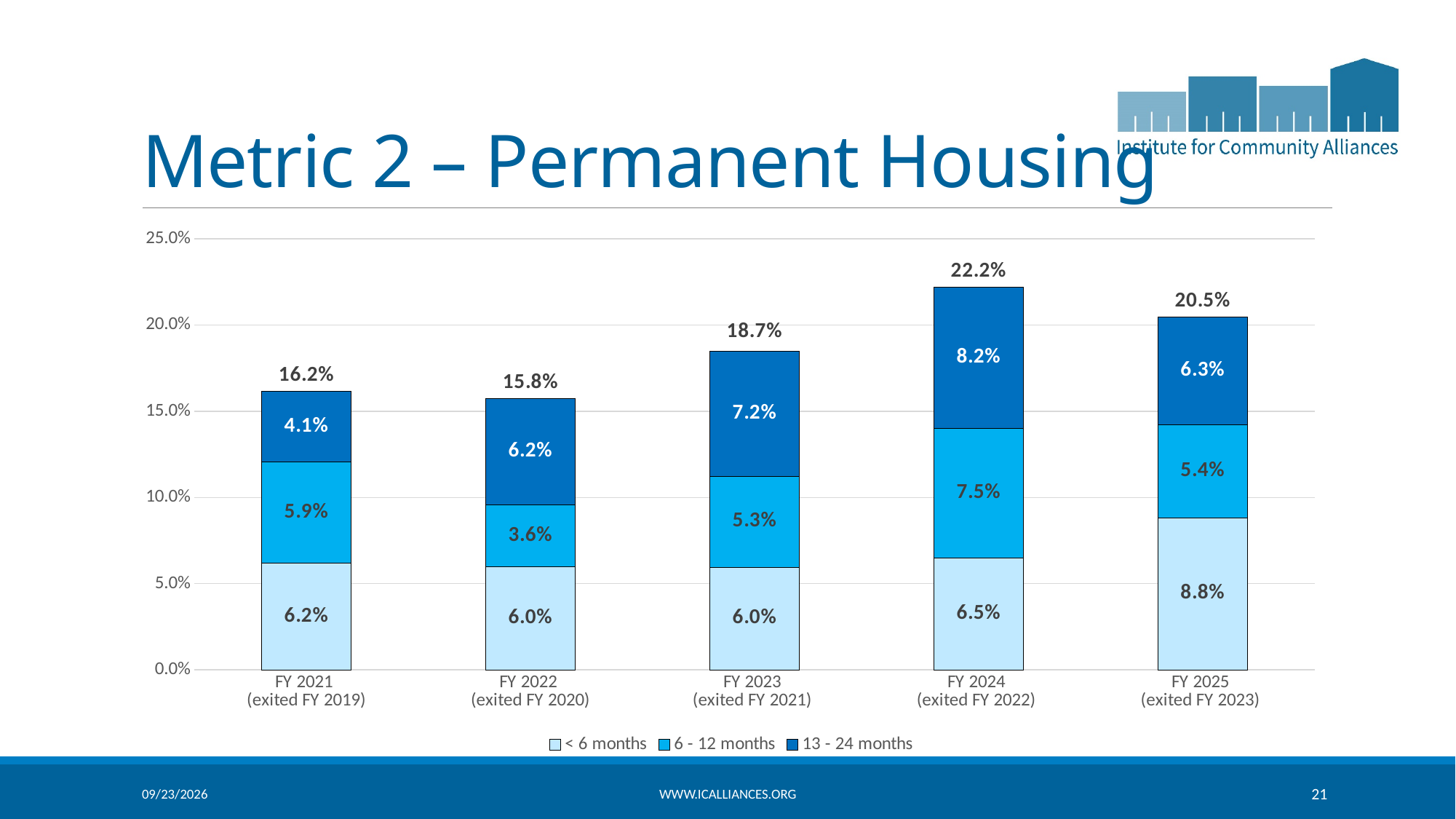
How many fiscal years are shown on the x axis? 5 Which is larger: the 6 - 12 months value in FY 2024 or the 6 - 12 months value in FY 2025? FY 2024 Which fiscal year has the highest total stacked bar? FY 2024 What kind of chart is shown on the slide? Stacked bar chart What is the value for the < 6 months series in FY 2025? 8.8% Which fiscal year has the lowest total stacked bar? FY 2022 What is the difference between the total for FY 2024 and the total for FY 2021? 6.0% What is the value for the 6 - 12 months series in FY 2022? 3.6% Is the total for FY 2025 greater or less than 20.0%? greater What is the value for the 13 - 24 months series in FY 2024? 8.2% How many series does the legend list? 3 What is the total of the stacked bar for FY 2023? 18.7%